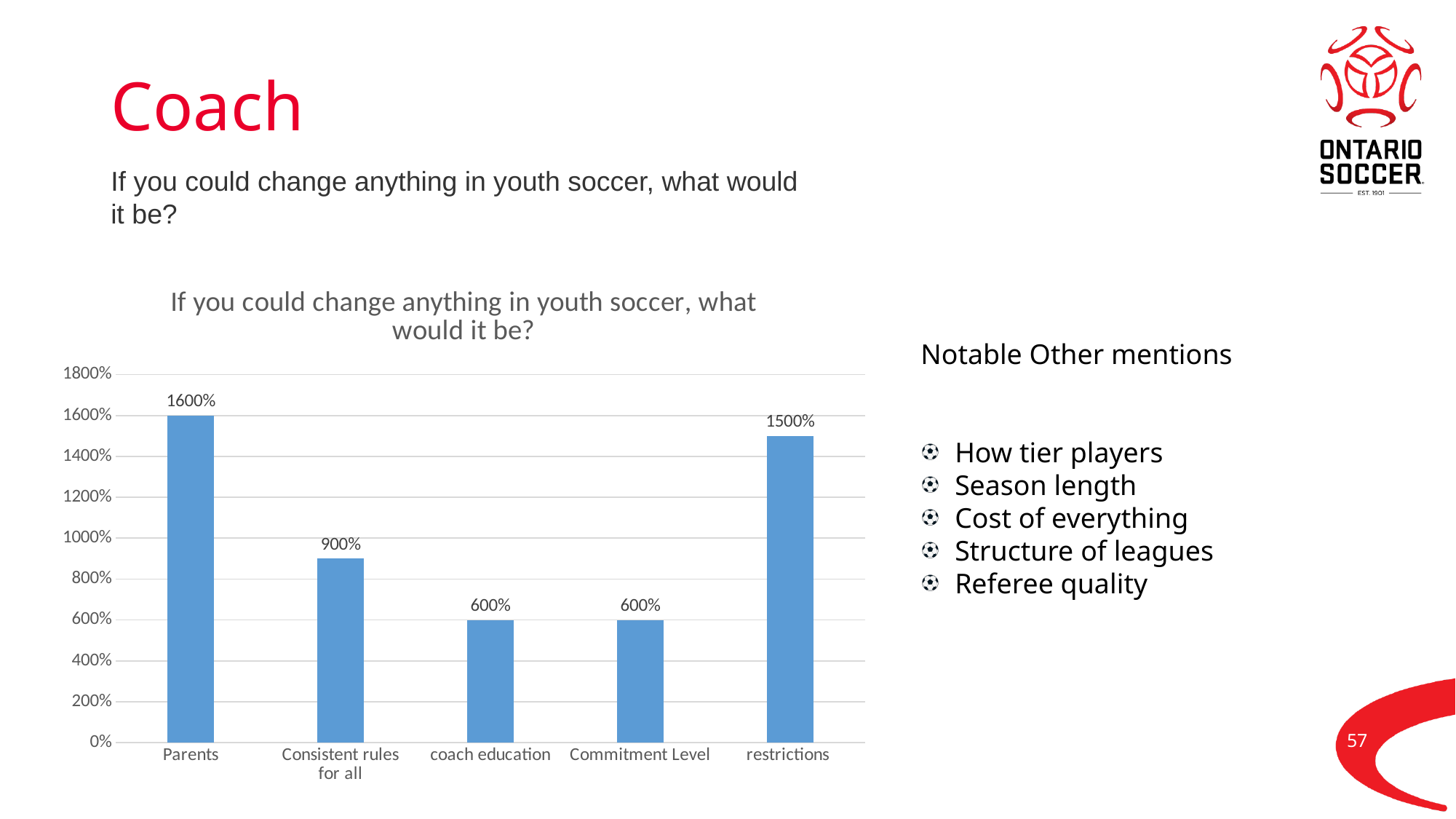
What is the difference between the values for Parents and restrictions? 100% What is the title of the chart? If you could change anything in youth soccer, what would it be? What is the difference between the values for Consistent rules for all and Commitment Level? 300% What is the value for coach education? 600% What kind of chart is shown on the slide? bar chart What is the value for Parents? 1600% What is the value for Consistent rules for all? 900% Which is larger, the value for Consistent rules for all or the value for coach education? Consistent rules for all Is the value for restrictions greater or less than 1400%? greater Which category has the highest value? Parents How many categories are shown on the x axis? 5 What is the value for restrictions? 1500%